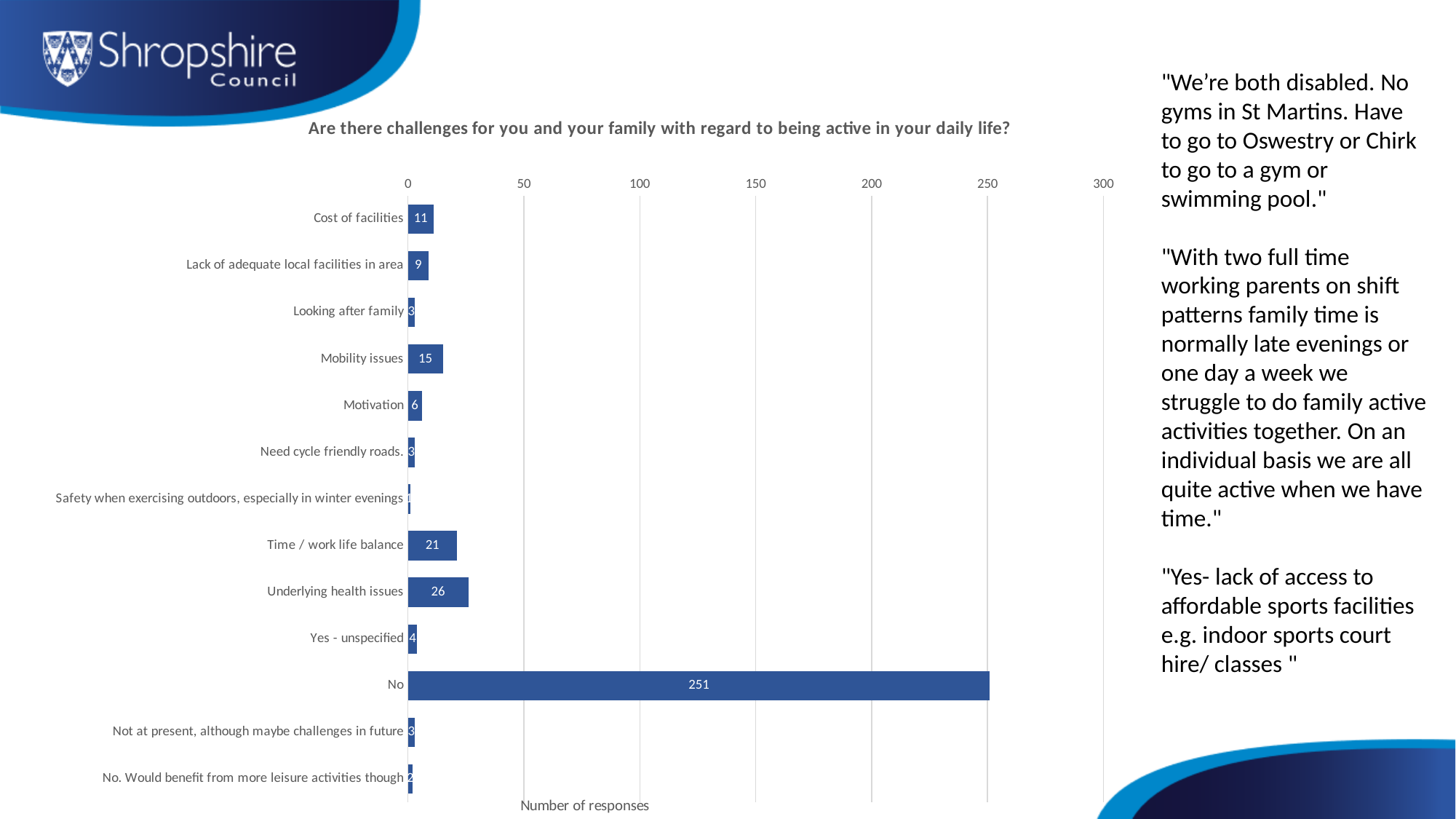
What kind of chart is shown on the slide? Bar chart What is the number of responses for "Underlying health issues"? 26 What is the number of responses for "Mobility issues"? 15 Which has more responses, "Cost of facilities" or "Lack of adequate local facilities in area"? Cost of facilities Which category has the highest number of responses? No What is the number of responses for "Time / work life balance"? 21 What is the label on the horizontal axis of the chart? Number of responses What is the number of responses for "No"? 251 What is the difference in responses between "Underlying health issues" and "Time / work life balance"? 5 How many categories are shown on the chart? 13 What is the title of the chart? Are there challenges for you and your family with regard to being active in your daily life? Is the value for "No" greater or less than 250? greater